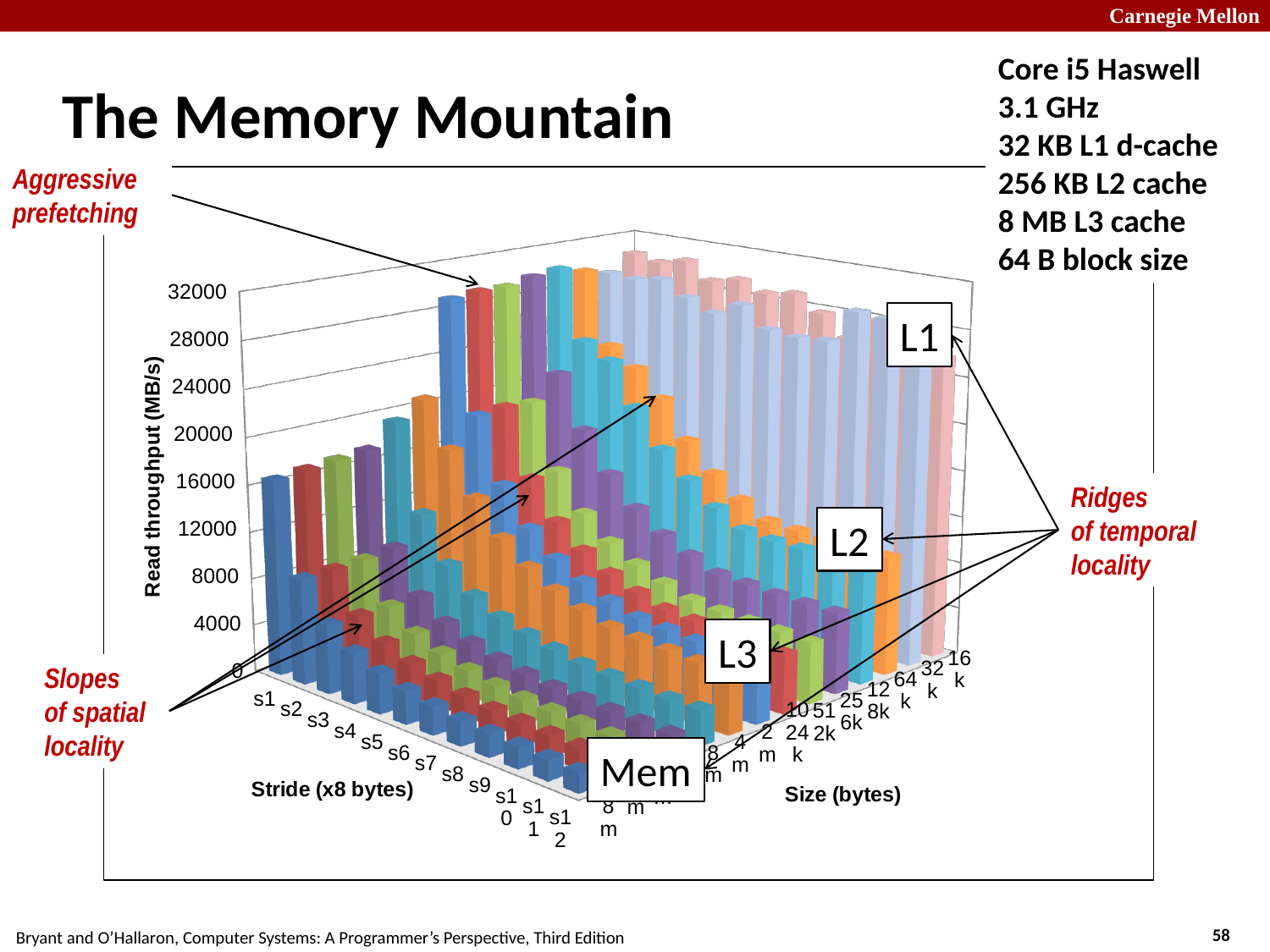
At the largest size (128m), which stride has the larger read throughput, s1 or s12? s1 What is the highest tick value shown on the vertical axis? 32000 What is the title of the vertical axis of the chart? Read throughput (MB/s) Is the read throughput for stride s12 at the largest size (128m) greater or less than 8000? less For a given size, does read throughput rise or fall as the stride increases from s1 to s12? fall How many stride categories (s1, s2, ...) are shown along the stride axis? 12 Is the read throughput for stride s1 at the largest size (128m) greater or less than 8000? greater What kind of chart is shown on the slide? bar chart Is the read throughput for stride s1 at the smallest sizes (L1 ridge) greater or less than 24000? greater Which four labels mark the ridges of temporal locality on the chart? L1, L2, L3, Mem For a given stride, does read throughput rise or fall as the working-set size increases from 16k to 128m? fall